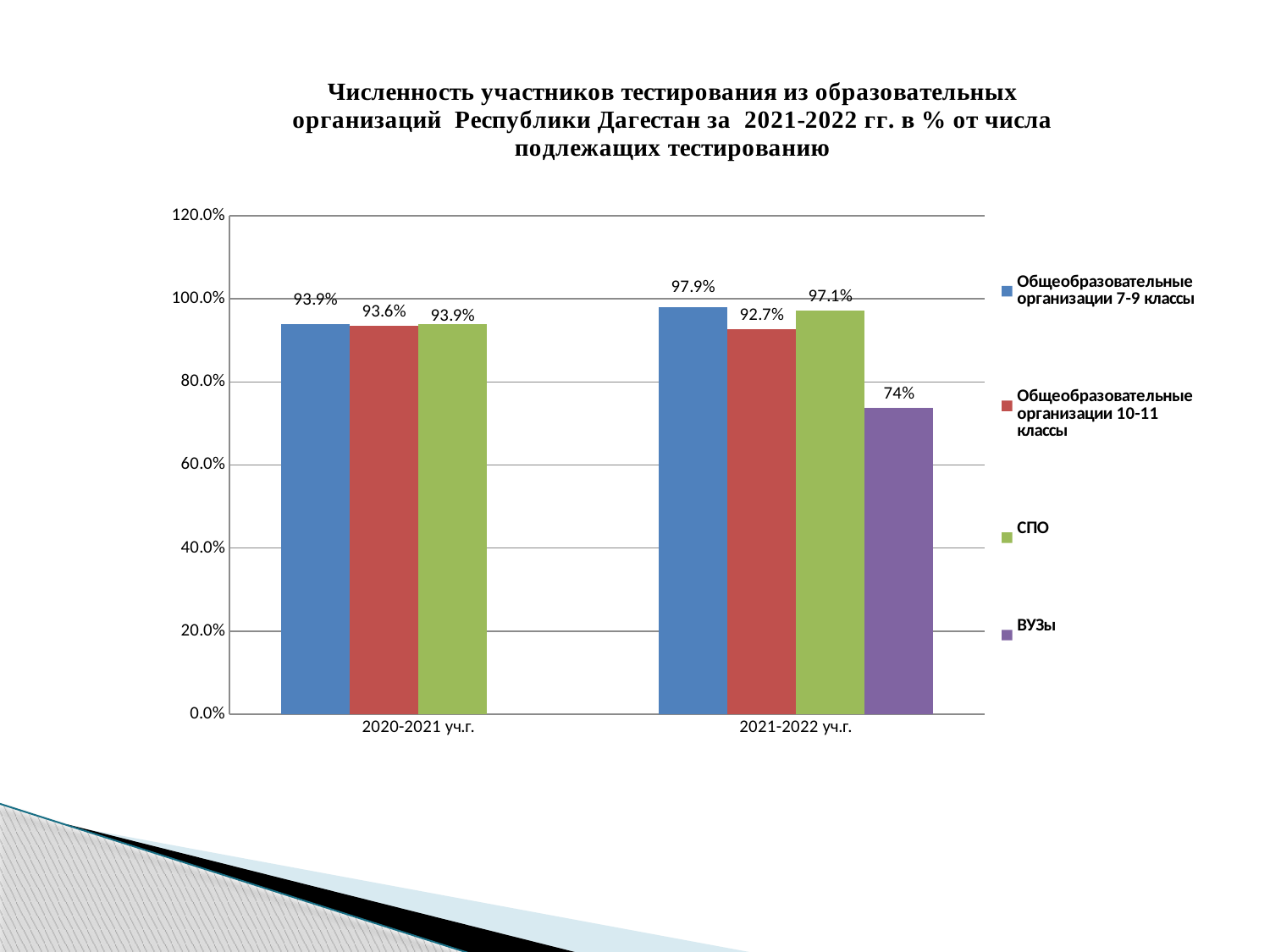
Which series has the highest value in 2021-2022 уч.г.? Общеобразовательные организации 7-9 классы What is the difference between the value for Общеобразовательные организации 7-9 классы in 2021-2022 уч.г. and in 2020-2021 уч.г.? 4.0% Which is larger: the value for СПО in 2021-2022 уч.г. or the value for ВУЗы in 2021-2022 уч.г.? СПО in 2021-2022 уч.г. What is the value for Общеобразовательные организации 7-9 классы in 2021-2022 уч.г.? 97.9% What is the value for Общеобразовательные организации 10-11 классы in 2021-2022 уч.г.? 92.7% Is the value for ВУЗы in 2021-2022 уч.г. greater or less than 80.0%? less How many categories are shown on the x axis? 2 What is the value for ВУЗы in 2021-2022 уч.г.? 74% How many series does the legend list? 4 What type of chart is shown on the slide? bar chart Which series has the lowest value in 2021-2022 уч.г.? ВУЗы What is the value for СПО in 2020-2021 уч.г.? 93.9%